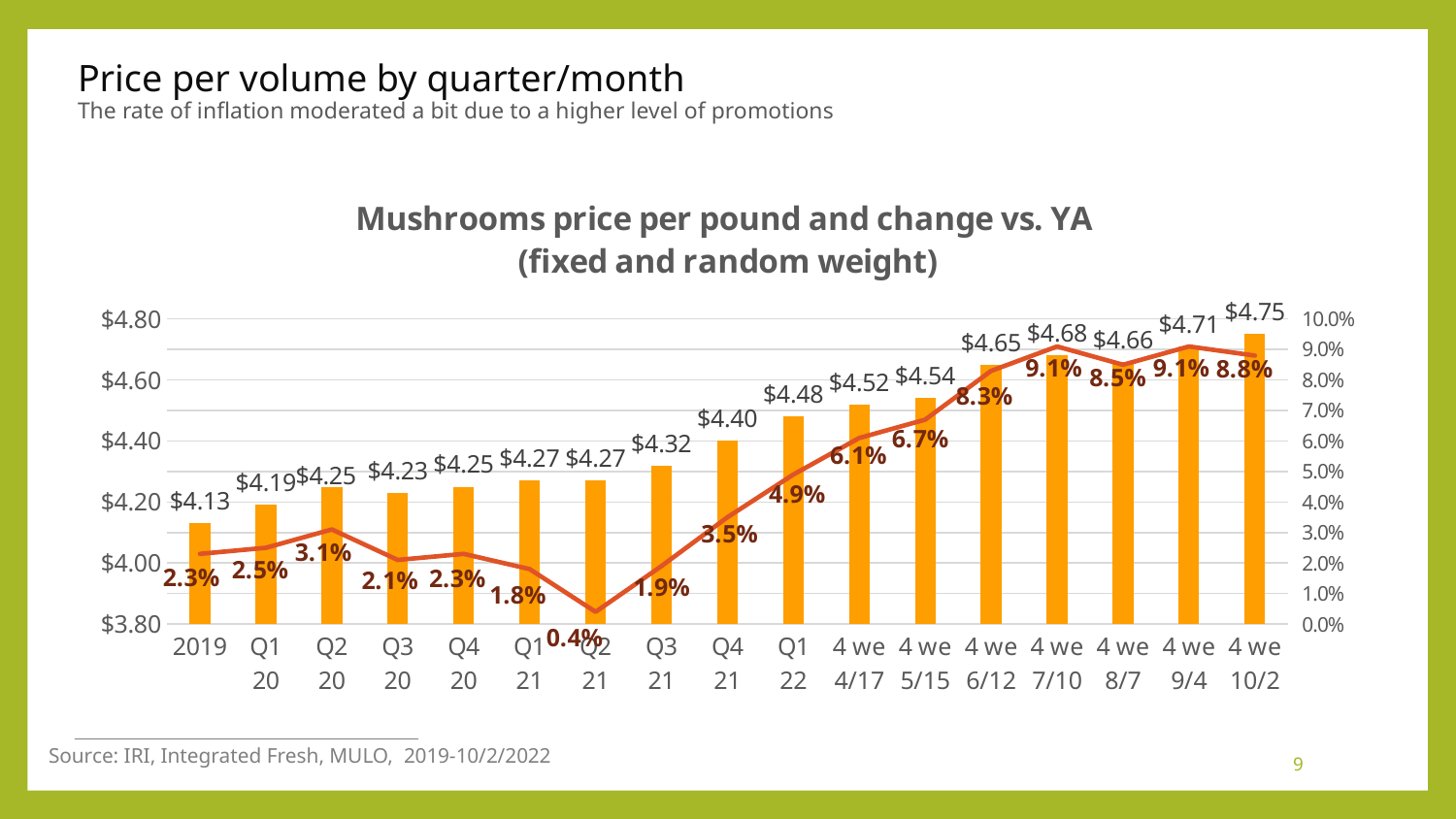
What is the change vs. YA shown for the 4 we 6/12 period? 8.3% What is the difference in price per pound between 4 we 10/2 and 2019? $0.62 Which period has the highest price per pound? 4 we 10/2 Which has the higher price per pound, Q3 20 or Q4 20? Q4 20 What kind of chart is this? Bar chart with a line How many periods are shown along the x axis? 17 What is the highest change vs. YA value shown on the chart? 9.1% What is the price per pound shown for Q4 21? $4.40 Which period has the lowest change vs. YA? Q2 21 What is the change vs. YA shown for Q1 22? 4.9% Which period has the lowest price per pound? 2019 Do the price per pound bars generally rise or fall from left to right? Rise